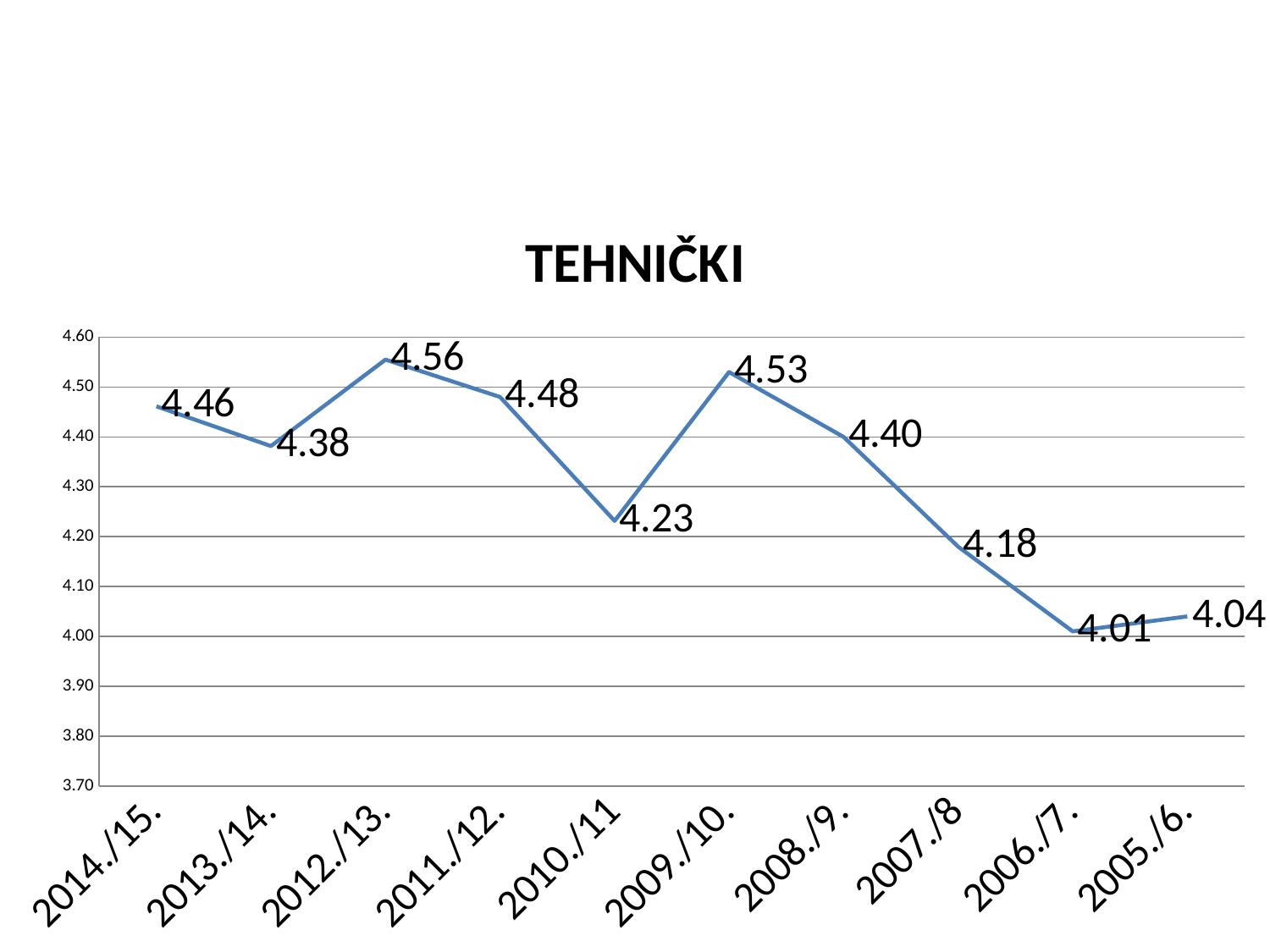
What is the value for 2010./11? 4.23 What is the value for 2012./13.? 4.56 What is the difference between the values for 2012./13. and 2006./7.? 0.55 How many data points are plotted on the chart? 10 What kind of chart is shown? line chart Which category has the highest value? 2012./13. What is the value for 2006./7.? 4.01 Which is larger, the value for 2009./10. or the value for 2008./9.? 2009./10. Do the values generally rise or fall from 2009./10. to 2006./7. along the x axis? fall Is the value for 2007./8 greater or less than 4.30? less Which category has the lowest value? 2006./7. What is the title of the chart? TEHNIČKI